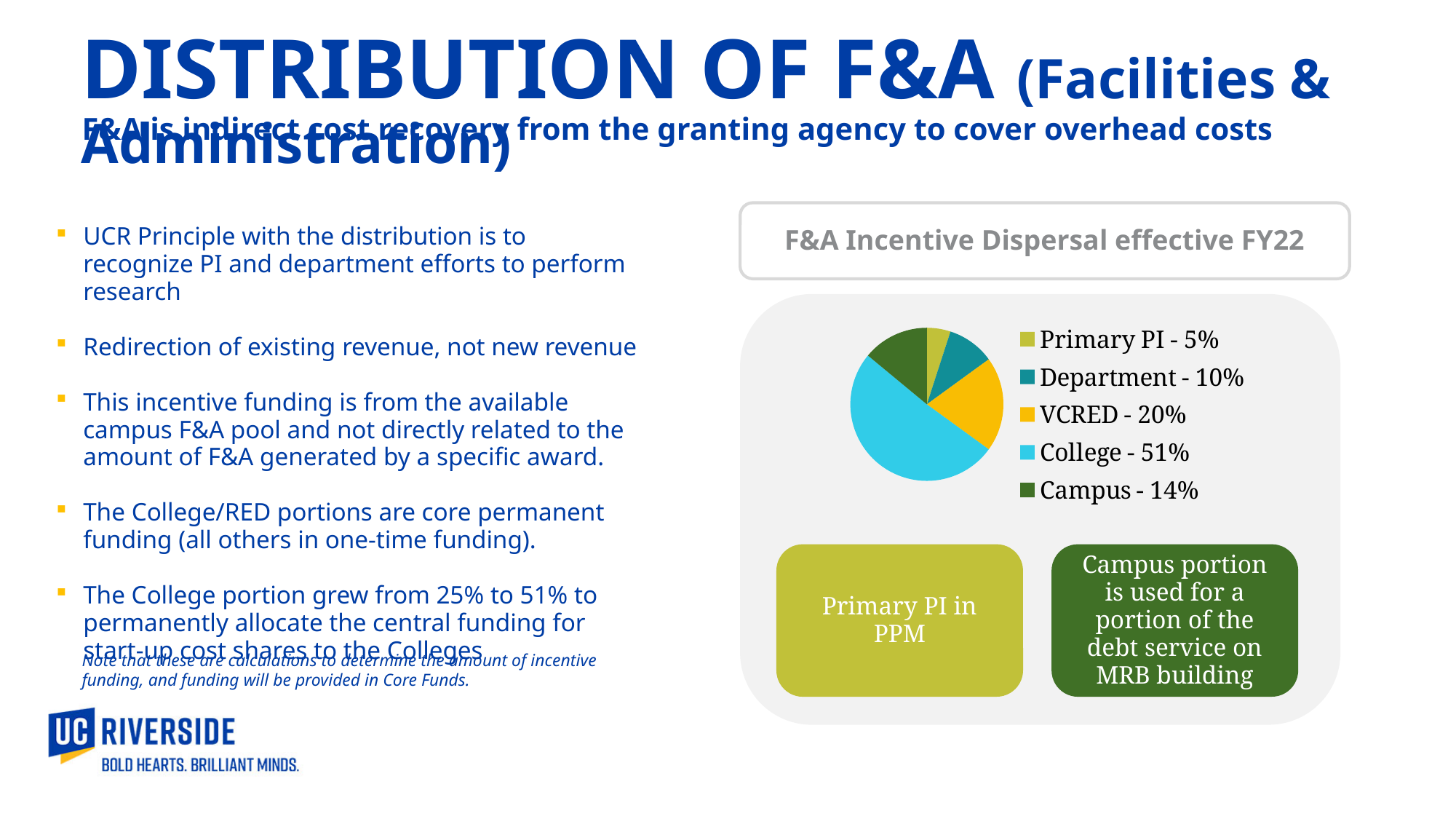
What is the difference in percentage points between the College and VCRED shares? 31 What share of the pie does Campus receive? 14% What kind of chart is shown on the slide? pie chart What share of the pie does College receive? 51% How many categories does the pie chart have? 5 What share of the pie does Department receive? 10% Which is larger, the Campus share or the Department share? Campus Which category has the smallest slice of the pie? Primary PI What is the title shown above the pie chart? F&A Incentive Dispersal effective FY22 Which category has the largest slice of the pie? College